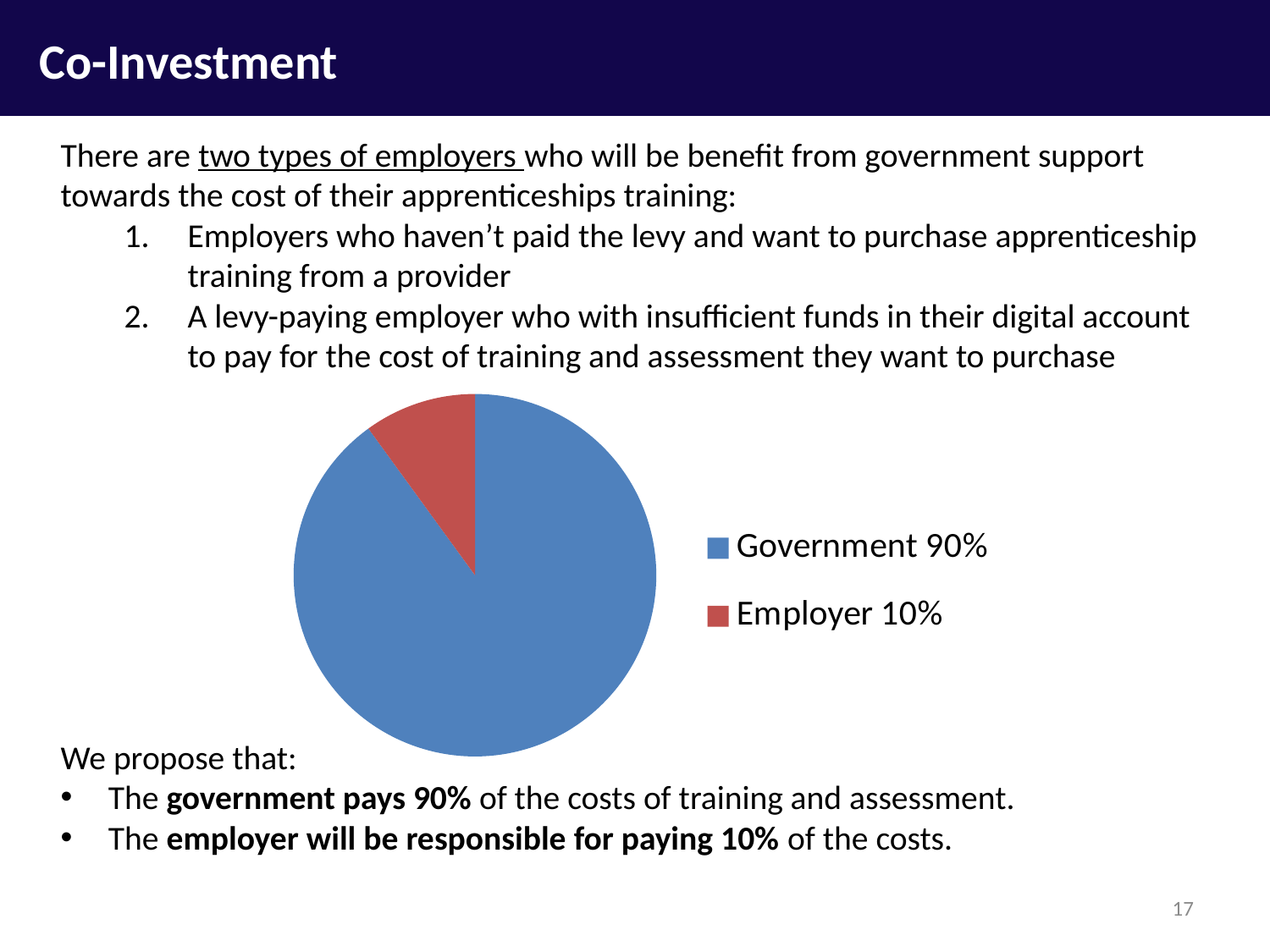
How many slices does the pie chart have? 2 What kind of chart is shown on the slide? pie chart Which slice of the pie chart is the smallest? Employer What share of the pie does the Government slice represent? 90% Which slice of the pie chart is the largest? Government How many entries does the legend of the pie chart list? 2 What is the difference in percentage points between the Government share and the Employer share? 80% What colour is the Government slice in the pie chart? blue Which is larger in the pie chart, the Government share or the Employer share? Government What colour is the Employer slice in the pie chart? red What share of the pie does the Employer slice represent? 10%